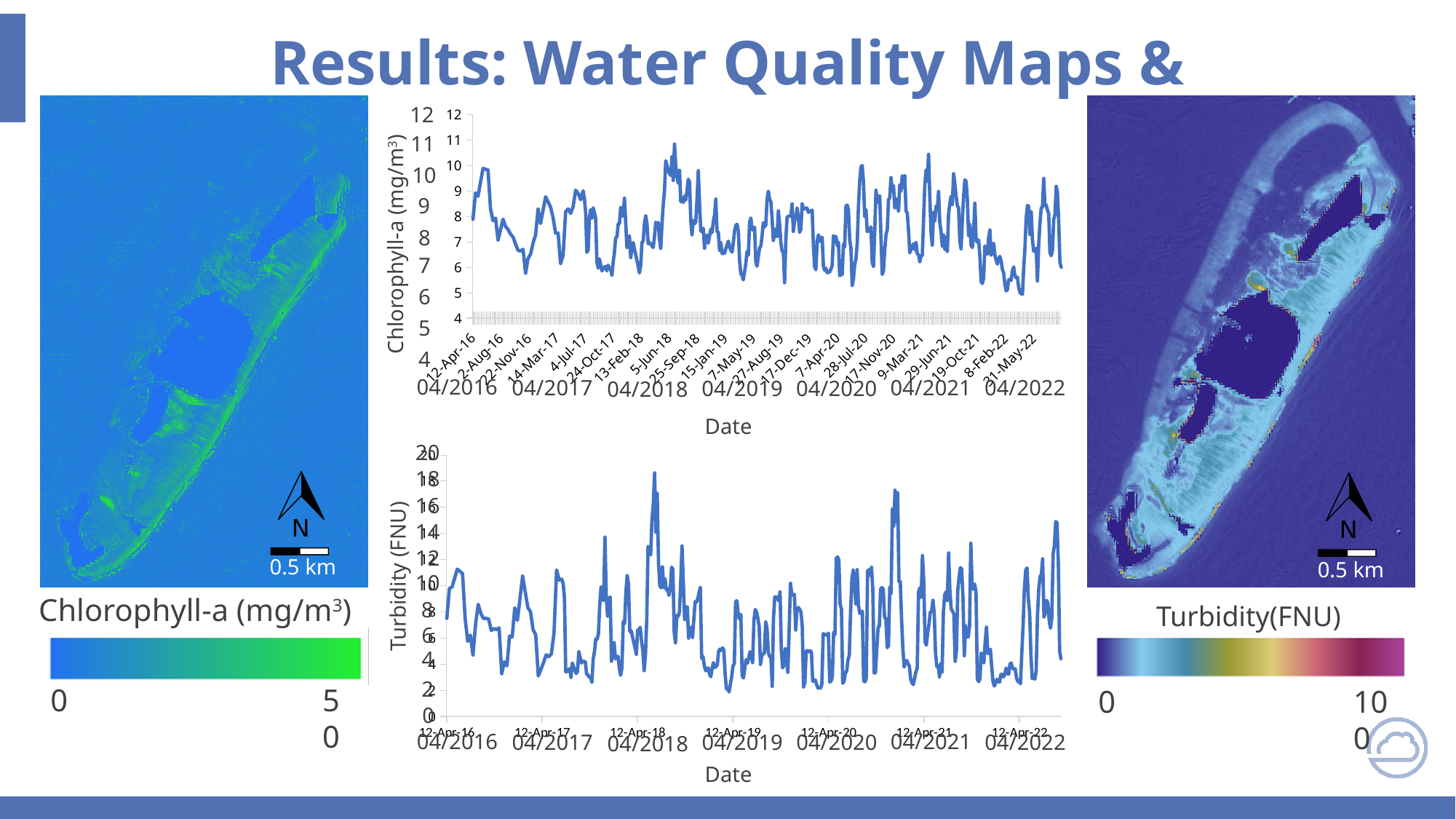
On the Turbidity line chart, is the peak value in 2018 greater or less than the peak value in 2021? greater On the Turbidity line chart, is the lowest value reached greater or less than 4? less On the Chlorophyll-a line chart, is the highest value reached greater or less than 10? greater What is the y-axis label on the top line chart? Chlorophyll-a (mg/m³) What kind of chart is the bottom chart with the y-axis labelled Turbidity (FNU)? line chart On the Turbidity line chart, is the highest value reached greater or less than 16? greater What is the x-axis label on the Turbidity line chart? Date How many line charts are shown on the slide? 2 How many data series are plotted on the Chlorophyll-a line chart? 1 What kind of chart is the top chart with the y-axis labelled Chlorophyll-a (mg/m³)? line chart